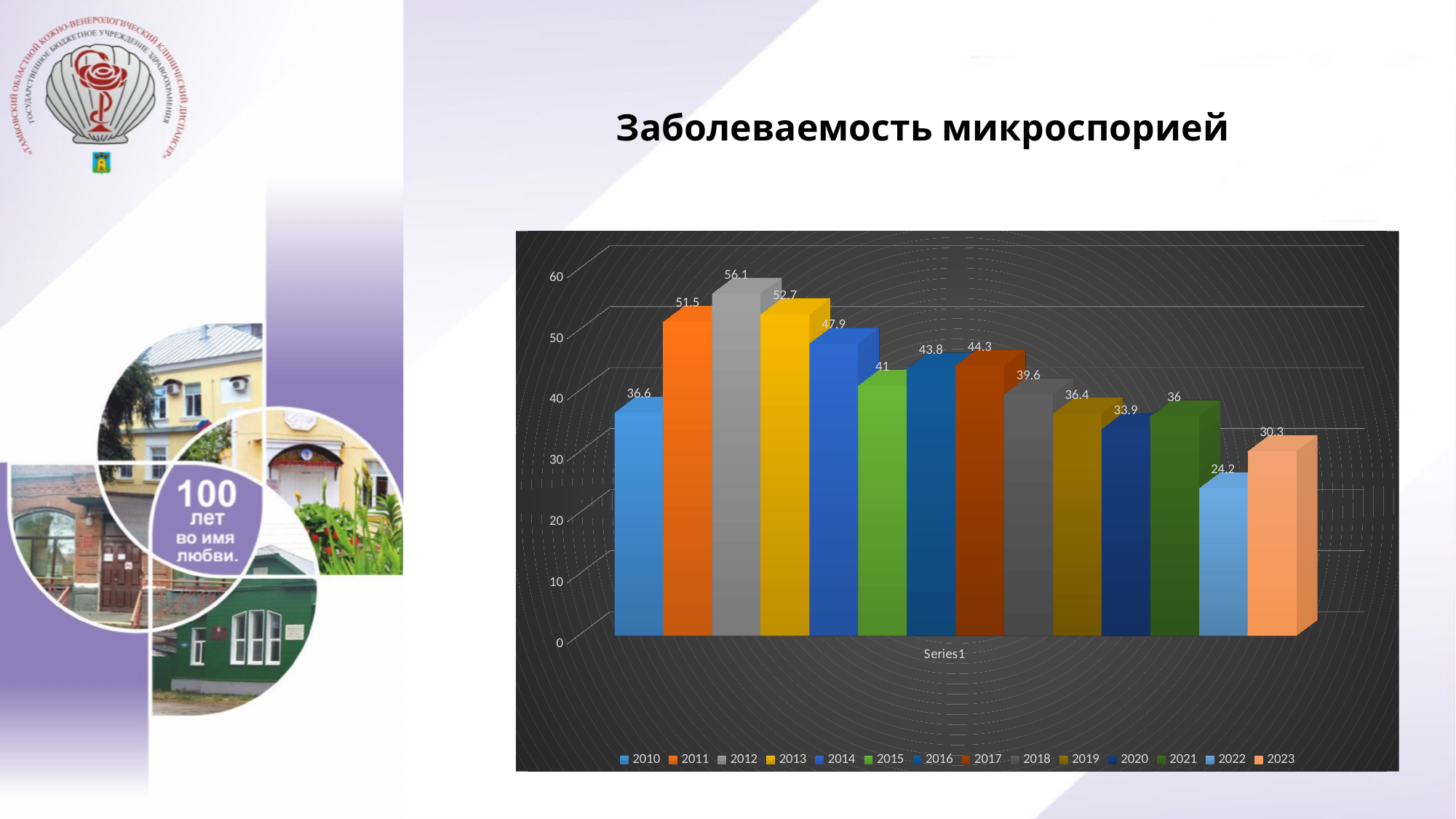
Which is larger, the value for 2014 or the value for 2015? 2014 Which year has the highest value? 2012 Which year has the lowest value? 2022 How many series does the legend list? 14 What is the difference between the values for 2011 and 2010? 14.9 What is the value for 2017? 44.3 What is the difference between the values for 2012 and 2022? 31.9 What is the value for 2023? 30.3 What is the title of the chart? Заболеваемость микроспорией What kind of chart is shown on the slide? Bar chart What is the value for 2022? 24.2 What is the value for 2012? 56.1